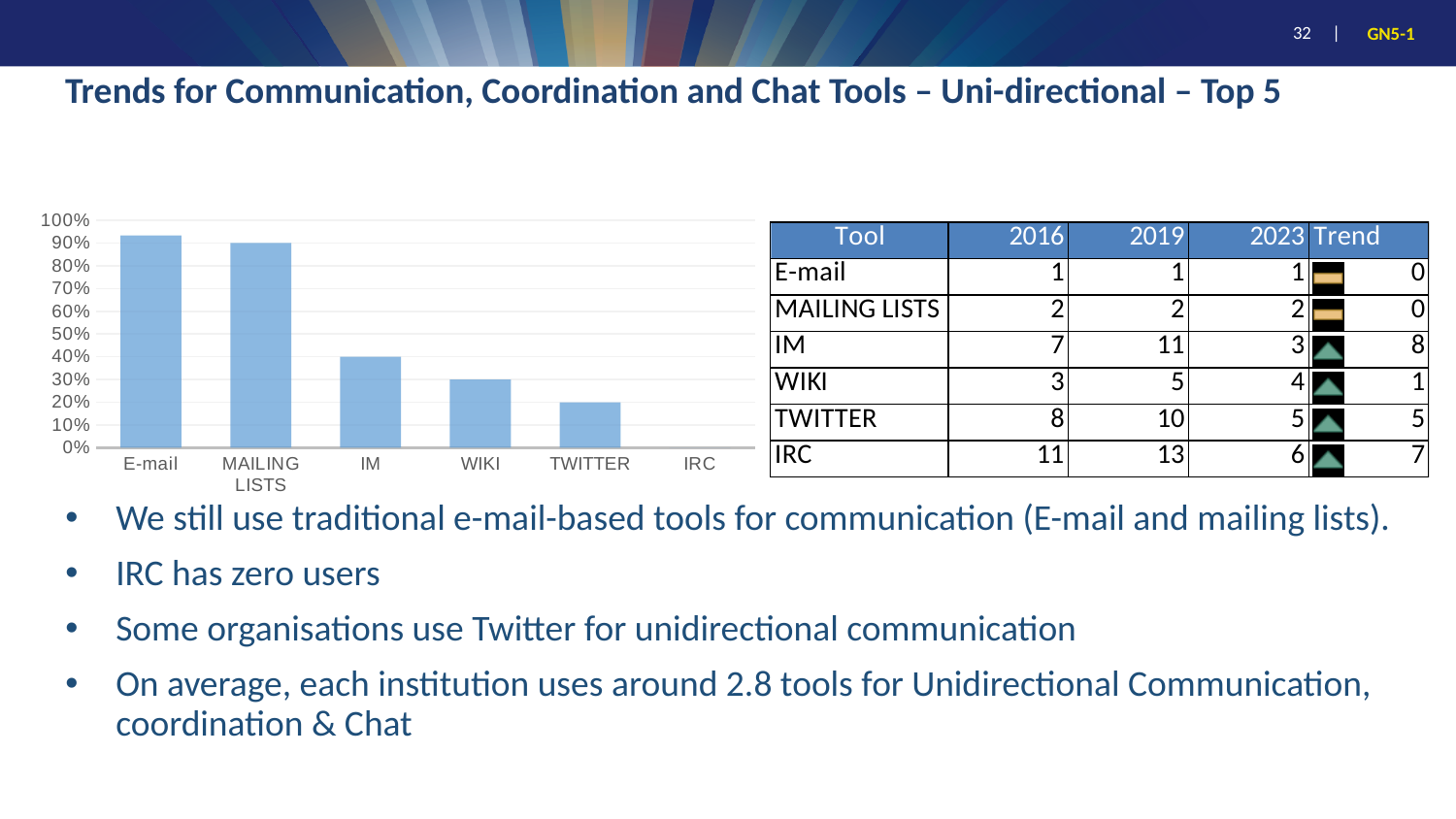
Is the value for WIKI greater or less than 40%? less Is the value for MAILING LISTS greater or less than 80%? greater Is the value for TWITTER greater or less than 30%? less What kind of chart is shown on the slide? bar chart Which category has the highest value in the bar chart? E-mail Which has a larger value in the bar chart, IM or WIKI? IM What is the value for IRC in the bar chart? 0% Which category has the lowest value in the bar chart? IRC How many categories are shown on the x axis of the bar chart? 6 Do the values in the bar chart rise or fall from left to right along the x axis? fall